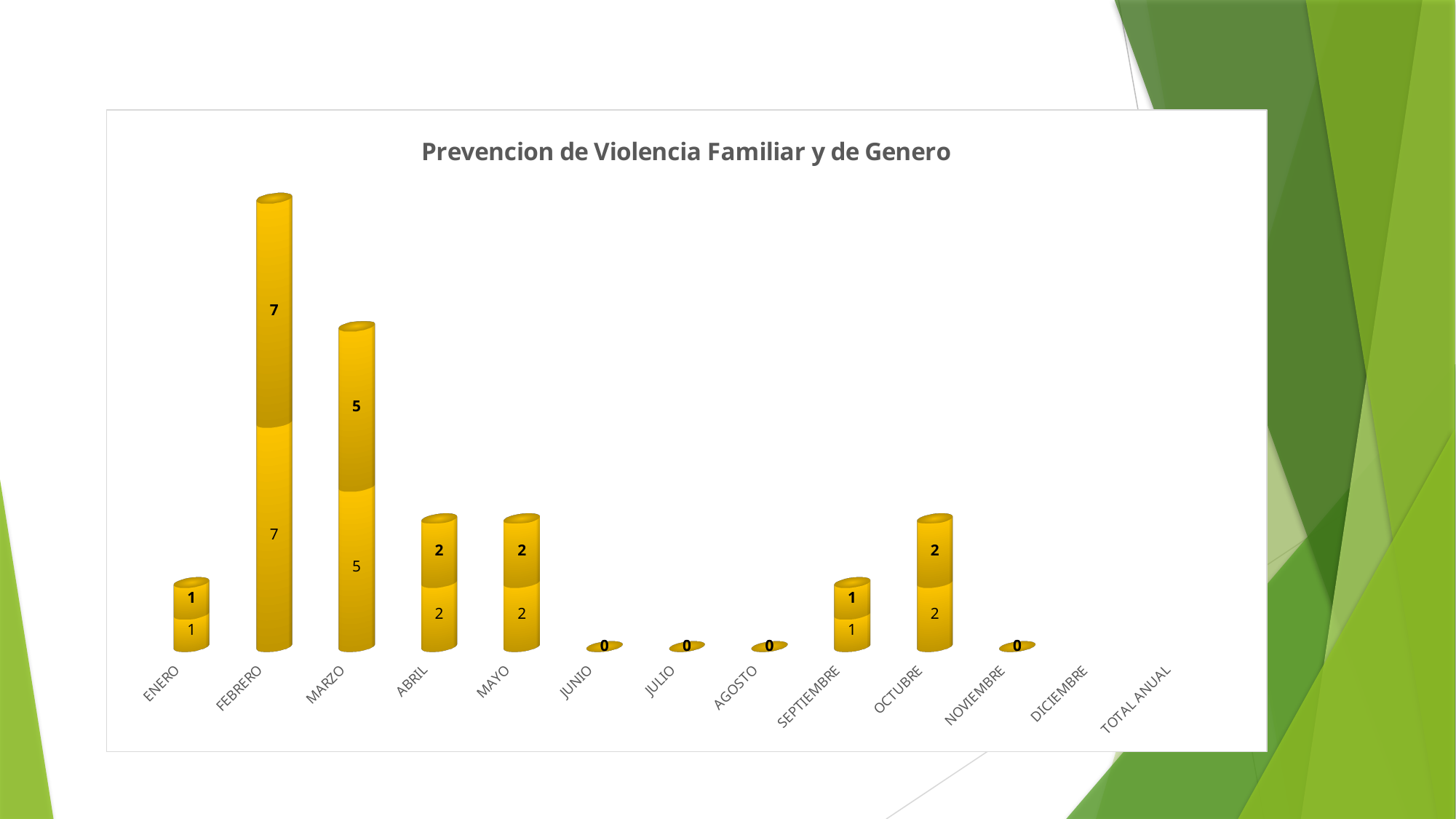
What value is printed on the upper segment of the MARZO bar? 5 What value is printed for JULIO? 0 What value is printed on the lower segment of the OCTUBRE bar? 2 What value is printed on the lower segment of the FEBRERO bar? 7 What is the total of the stacked FEBRERO bar? 14 Which bar is taller, ABRIL or SEPTIEMBRE? ABRIL Which month has the tallest bar? FEBRERO What is the difference between the lower segment values of FEBRERO and MARZO? 2 What kind of chart is shown on the slide? bar chart How many categories are listed along the x axis of the chart? 13 What is the title of the chart? Prevencion de Violencia Familiar y de Genero What is the total of the stacked MARZO bar? 10